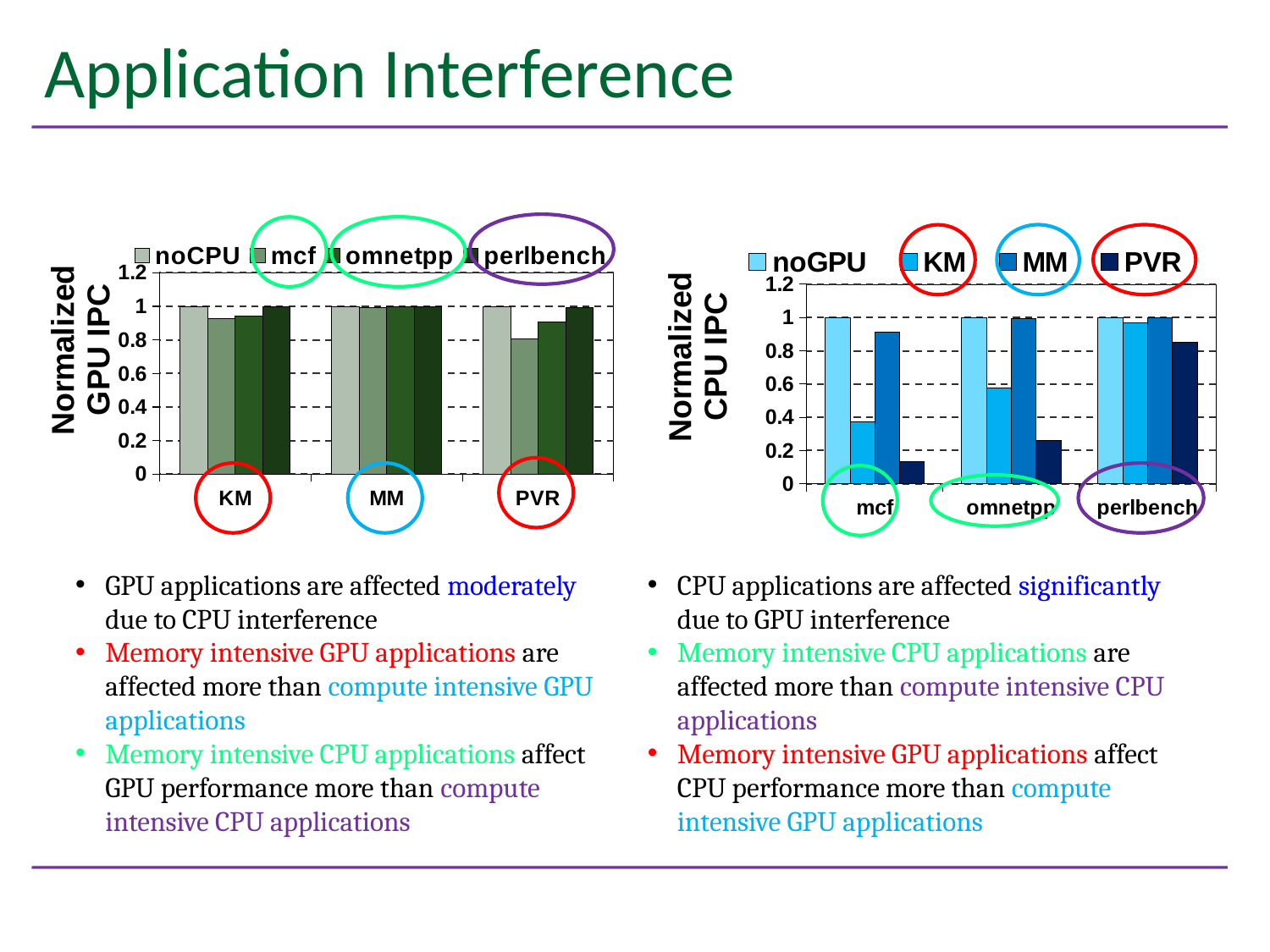
How many series does the legend of the Normalized GPU IPC chart list? 4 In the Normalized CPU IPC chart, is the KM value for omnetpp greater or less than 0.4? greater What kind of chart is the Normalized GPU IPC chart on the left? bar chart How many series does the legend of the Normalized CPU IPC chart list? 4 In the Normalized CPU IPC chart, which category has the highest PVR bar? perlbench In the Normalized CPU IPC chart, which is larger for omnetpp, KM or MM? MM In the Normalized CPU IPC chart, is the PVR value for mcf greater or less than 0.2? less How many categories are shown on the x axis of the Normalized GPU IPC chart? 3 In the Normalized GPU IPC chart, which category has the lowest mcf bar? PVR In the Normalized CPU IPC chart, is the PVR value for perlbench greater or less than 0.6? greater In the Normalized CPU IPC chart, which series has the lowest value for mcf? PVR